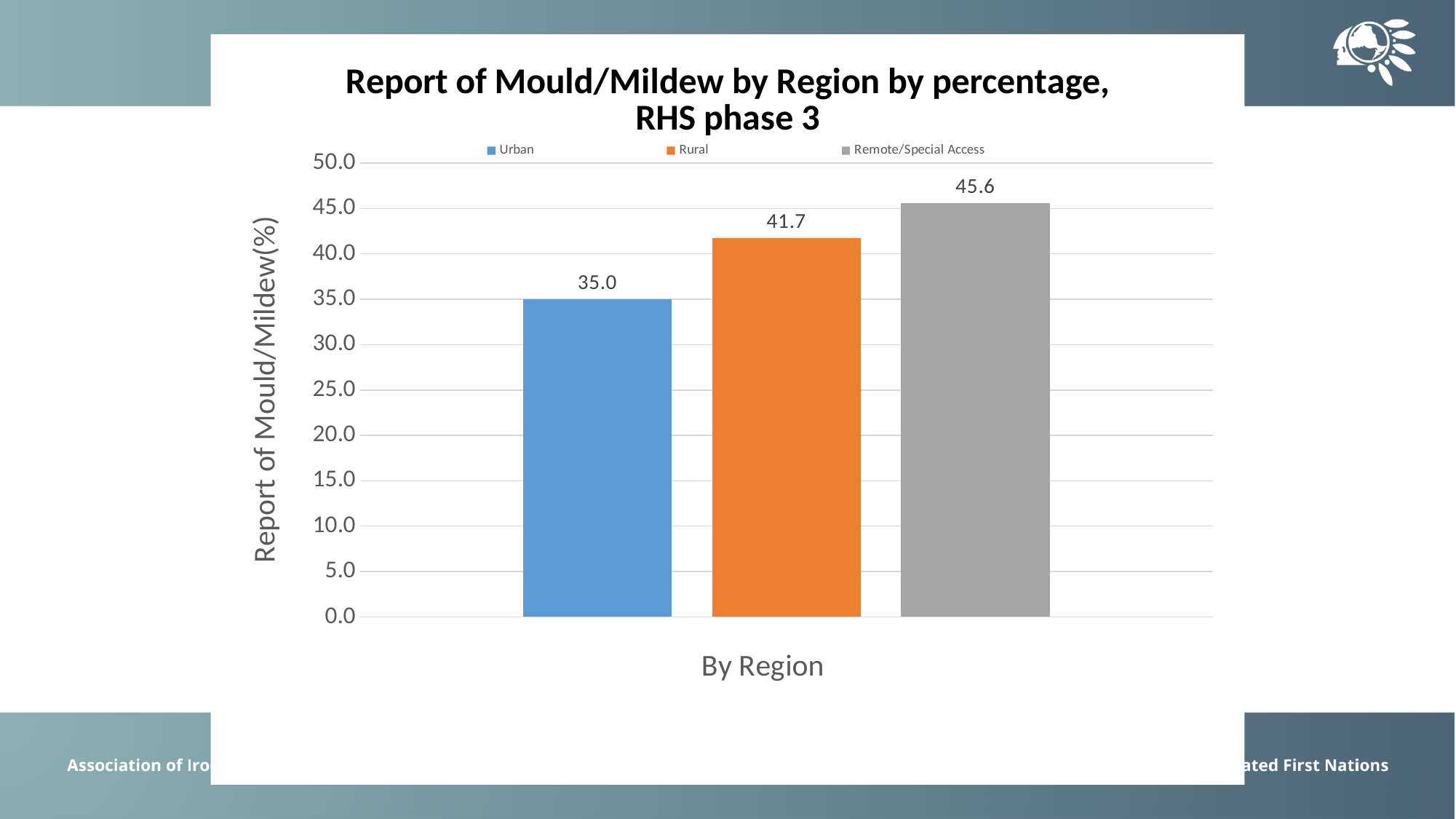
How many series does the legend list? 3 What is the value for Rural? 41.7 Is the value for Remote/Special Access greater or less than 45.0? greater Which region has the highest reported percentage of mould/mildew? Remote/Special Access What is the value for Urban? 35.0 What is the difference between the Remote/Special Access value and the Urban value? 10.6 What kind of chart is shown on the slide? Bar chart What is the value for Remote/Special Access? 45.6 What is the difference between the Rural value and the Urban value? 6.7 What is the title of the chart? Report of Mould/Mildew by Region by percentage, RHS phase 3 Which is larger, the value for Rural or the value for Urban? Rural Which region has the lowest reported percentage of mould/mildew? Urban